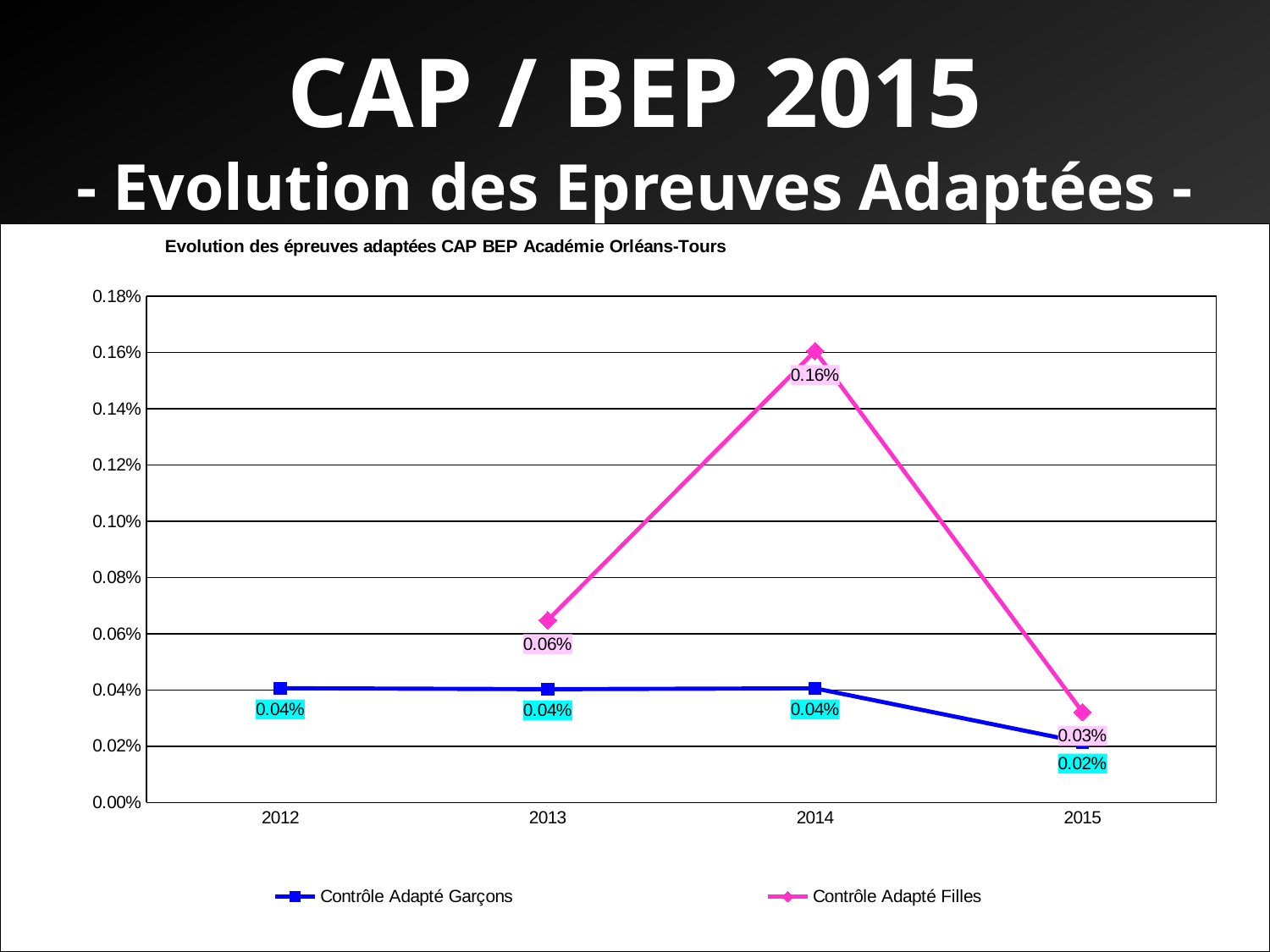
How many years are shown on the x axis? 4 What is the value for Contrôle Adapté Filles in 2013? 0.06% In which year is the value for Contrôle Adapté Garçons lowest? 2015 What is the value for Contrôle Adapté Garçons in 2015? 0.02% What type of chart is shown on the slide? Line chart What is the title of the chart? Evolution des épreuves adaptées CAP BEP Académie Orléans-Tours Which series has the larger value in 2015, Contrôle Adapté Garçons or Contrôle Adapté Filles? Contrôle Adapté Filles What is the difference between Contrôle Adapté Filles and Contrôle Adapté Garçons in 2014? 0.12% What is the value for Contrôle Adapté Filles in 2014? 0.16% What is the value for Contrôle Adapté Garçons in 2012? 0.04% How many series does the legend list? 2 In which year is the value for Contrôle Adapté Filles highest? 2014